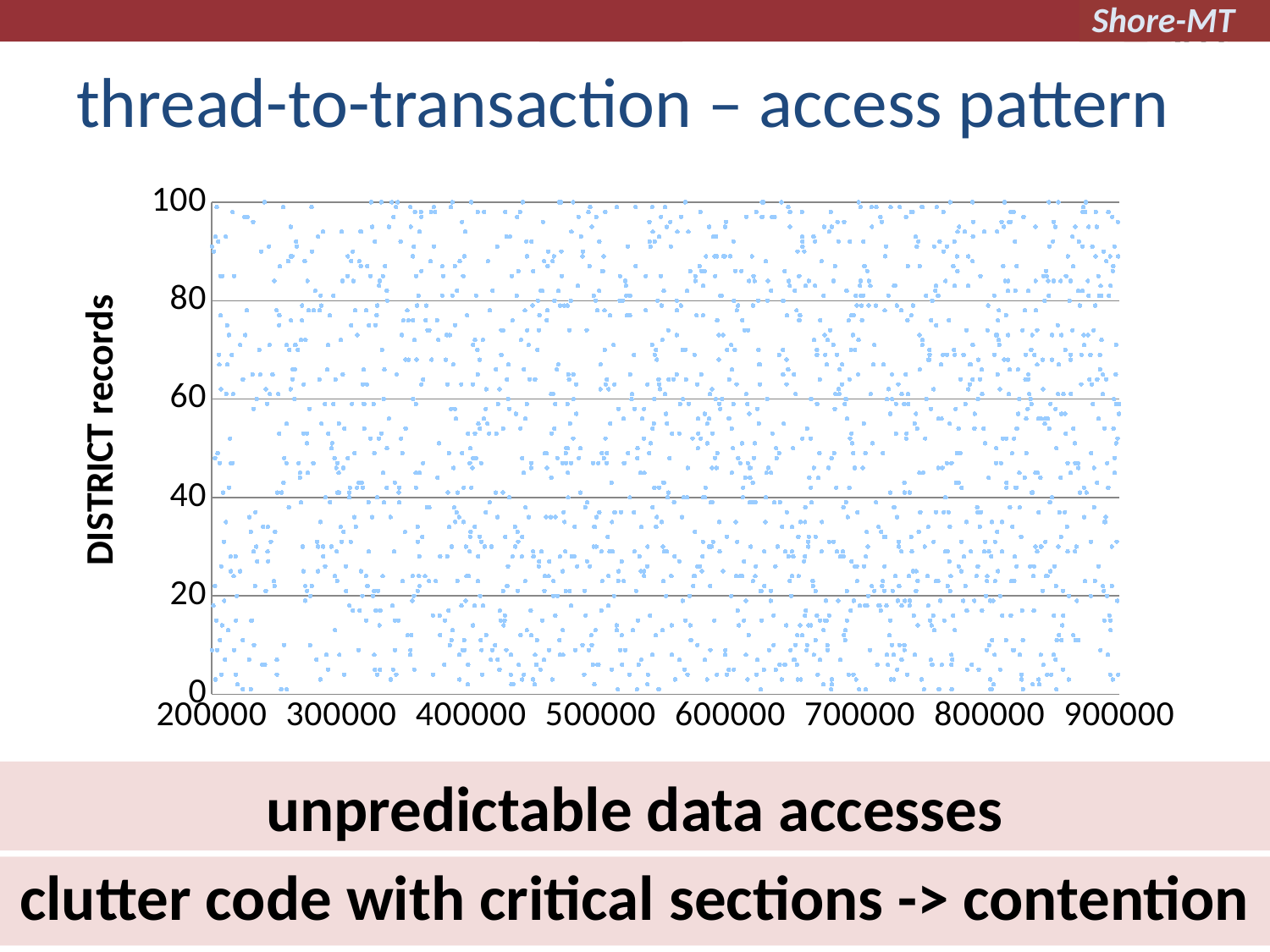
What kind of chart is shown on the slide? scatter chart What is the label of the vertical axis of the chart? DISTRICT records Do the plotted points show a clear rising or falling trend along the x axis? neither What is the highest tick value shown on the horizontal axis of the chart? 900000